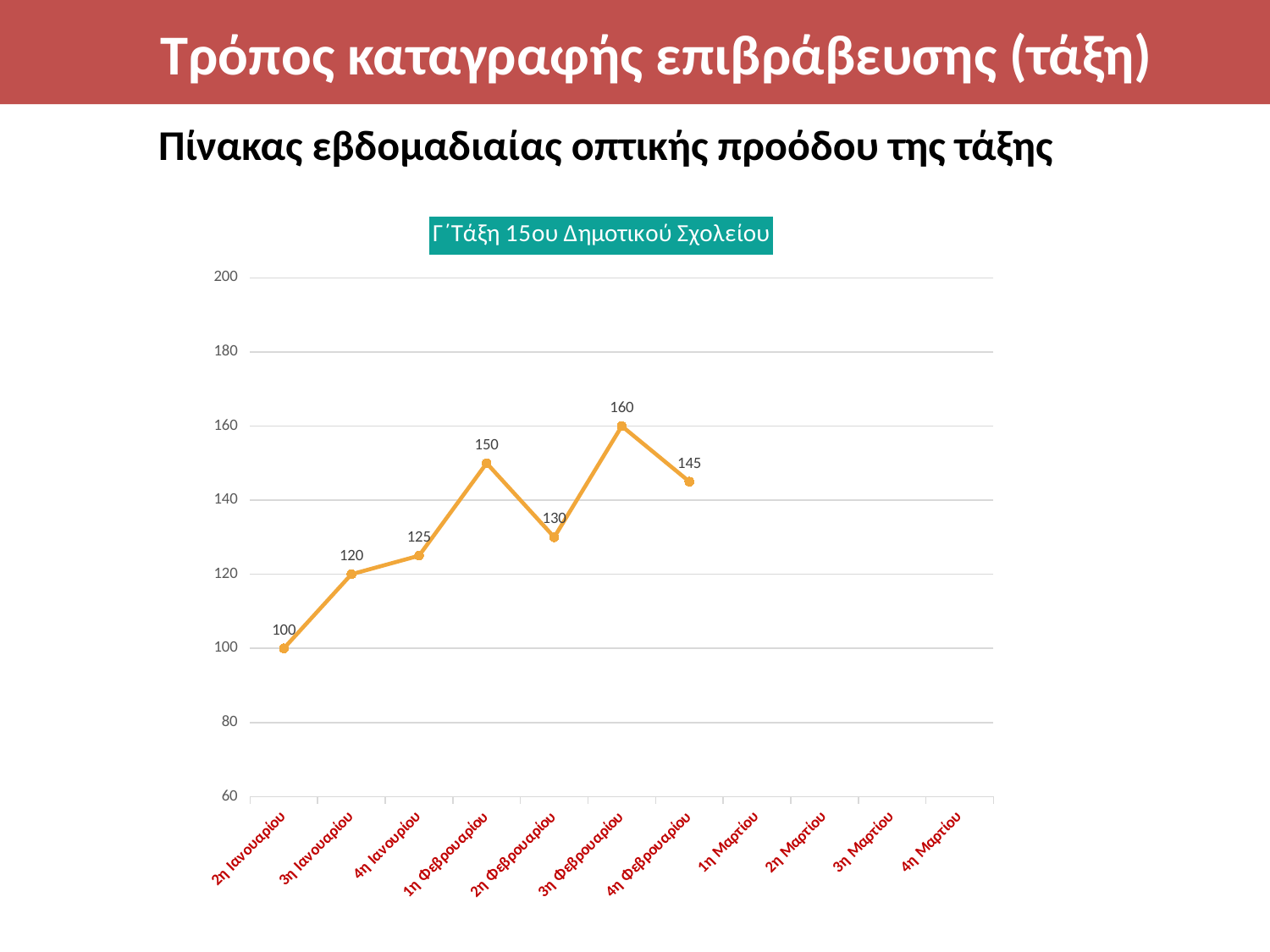
How many category labels are shown on the x axis? 11 What is the difference between the values for 3η Φεβρουαρίου and 2η Φεβρουαρίου? 30 Is the value for 4η Ιανουαρίου greater or less than 140? less What kind of chart is shown on the slide? line chart How many data points are plotted on the line? 7 What is the value for 1η Φεβρουαρίου? 150 What is the value for 4η Φεβρουαρίου? 145 Which week has the lowest value? 2η Ιανουαρίου What is the value for 2η Ιανουαρίου? 100 What is the title of the chart? Γ΄Τάξη 15ου Δημοτικού Σχολείου Which week has the highest value? 3η Φεβρουαρίου Which is larger, the value for 1η Φεβρουαρίου or the value for 4η Φεβρουαρίου? 1η Φεβρουαρίου